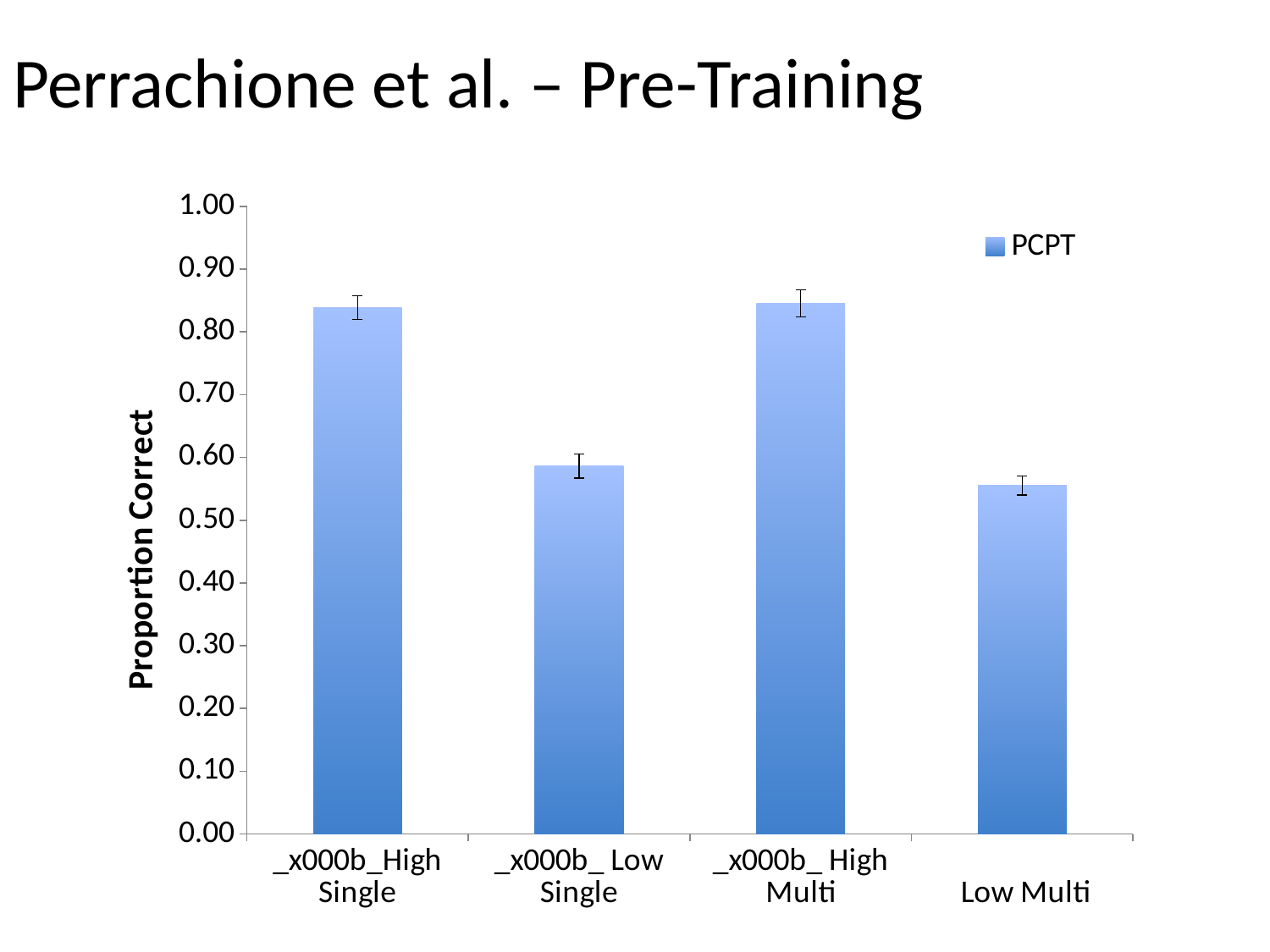
What kind of chart is shown on the slide? bar chart Is the value for Low Multi greater or less than 0.60? less How many series does the legend list? 1 Is the value for High Multi greater or less than 0.80? greater Is the value for Low Single greater or less than 0.70? less What is the name of the series shown in the legend? PCPT What is the label of the y axis? Proportion Correct Which is larger, the value for High Single or the value for Low Single? High Single Which is larger, the value for High Multi or the value for Low Multi? High Multi How many categories are plotted on the x axis? 4